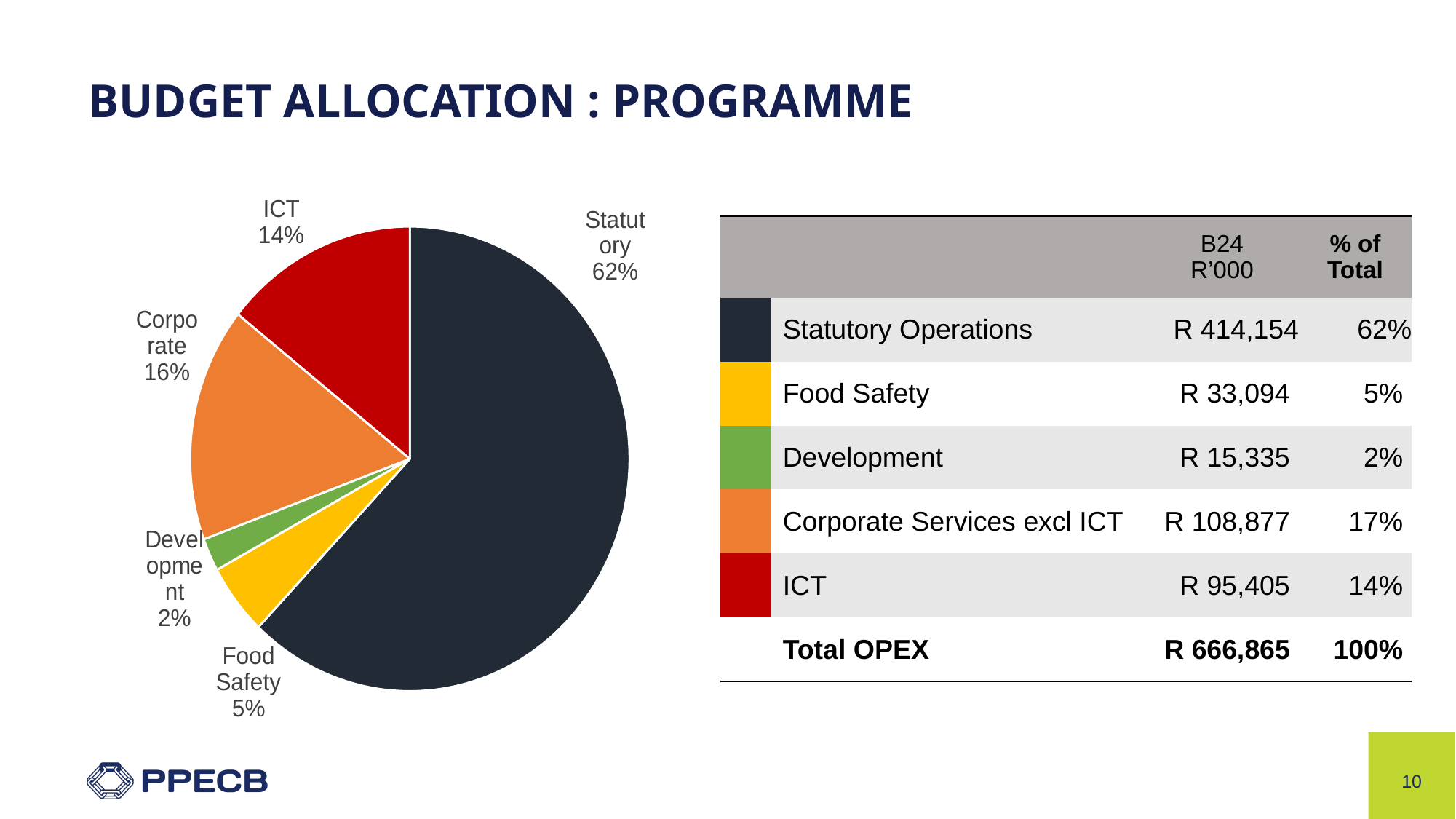
What is the difference in percentage points between the Statutory slice and the ICT slice in the pie chart? 48 What share of the pie does Development take? 2% Which slice of the pie chart is the largest? Statutory What colour is the Statutory slice in the pie chart? dark navy Which slice is larger in the pie chart, ICT or Food Safety? ICT What kind of chart is shown on the slide? pie chart What share of the pie does Statutory take? 62% What share of the pie does ICT take? 14% Which slice of the pie chart is the smallest? Development What colour is the ICT slice in the pie chart? red How many slices does the pie chart have? 5